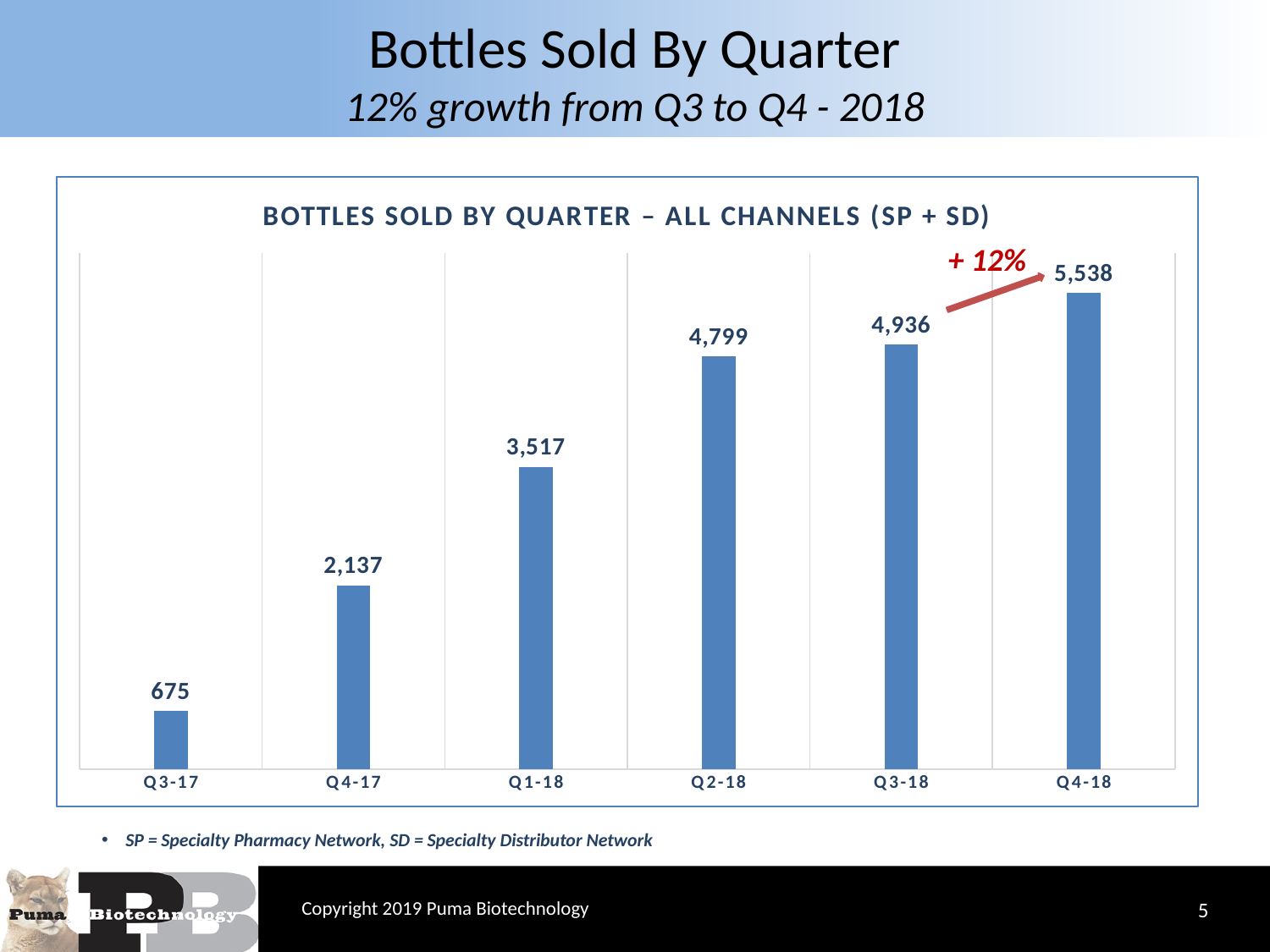
Which quarter has the highest number of bottles sold? Q4-18 What percentage growth is annotated between Q3-18 and Q4-18 on the chart? + 12% Do the values rise or fall from Q3-17 to Q4-18? Rise Which quarter has the lowest number of bottles sold? Q3-17 How many bottles were sold in Q1-18? 3,517 What type of chart is shown on the slide? Bar chart How many quarters are shown on the x axis of the chart? 6 What is the value shown for Q3-17? 675 What is the difference in bottles sold between Q4-17 and Q3-17? 1,462 How many bottles were sold in Q2-18? 4,799 What is the difference in bottles sold between Q4-18 and Q3-18? 602 Which quarter had more bottles sold, Q1-18 or Q2-18? Q2-18